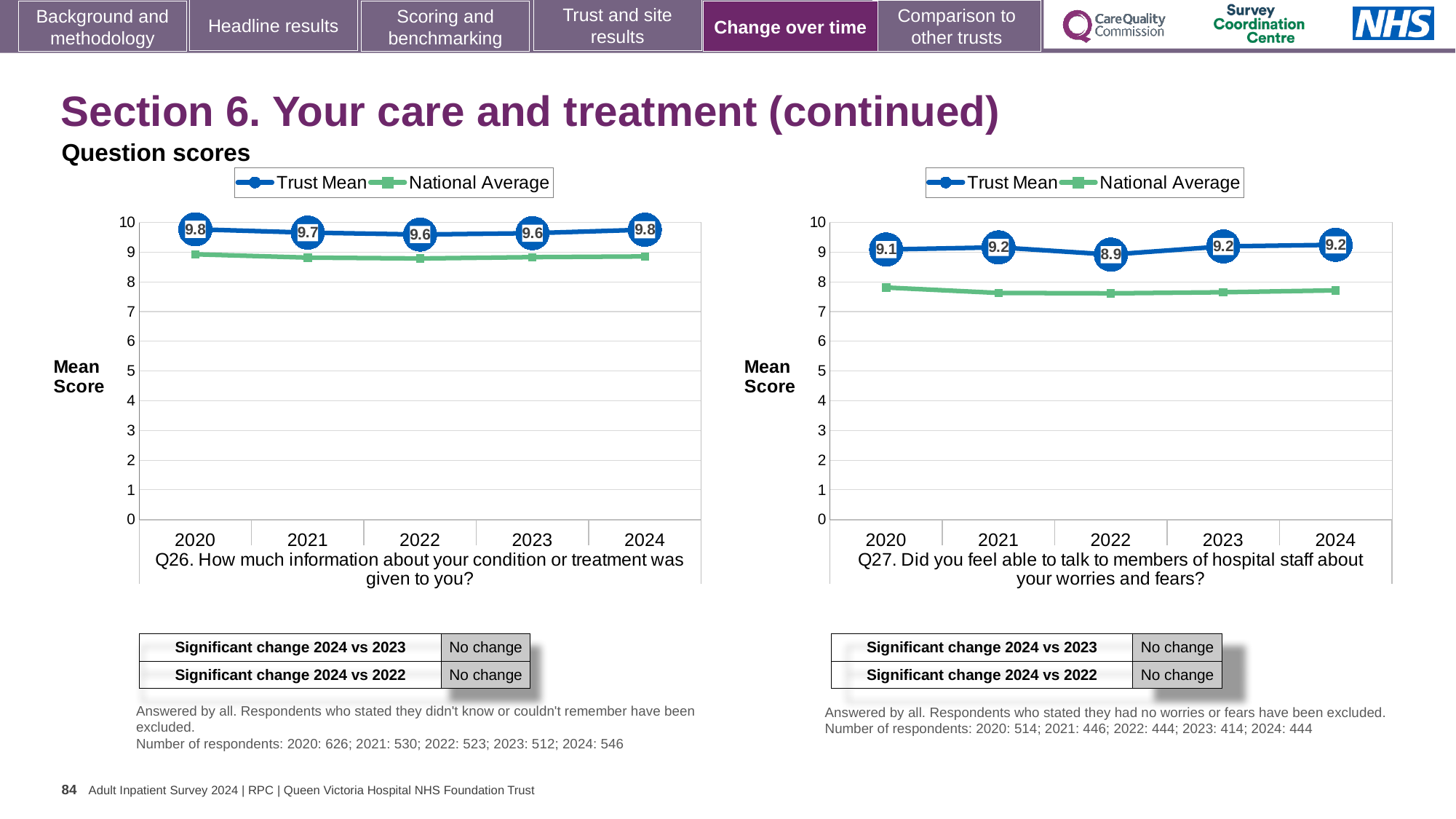
In the Q26 chart on the left, what is the Trust Mean value for 2022? 9.6 In the Q27 chart on the right, which year has the lowest Trust Mean value? 2022 How many series does the legend of the Q27 chart on the right list? 2 In the Q27 chart on the right, what is the difference between the Trust Mean values for 2023 and 2022? 0.3 In the Q27 chart on the right, what is the Trust Mean value for 2022? 8.9 What kind of chart is the Q26 chart on the left? Line chart In the Q27 chart on the right, what is the Trust Mean value for 2024? 9.2 In the Q26 chart on the left, is the National Average value for 2020 greater or less than 8? greater In the Q26 chart on the left, what is the Trust Mean value for 2020? 9.8 In the Q26 chart on the left, what is the difference between the Trust Mean values for 2020 and 2022? 0.2 How many years are shown on the x axis of the Q26 chart on the left? 5 In the Q27 chart on the right, is the National Average value for 2021 greater or less than 8? less